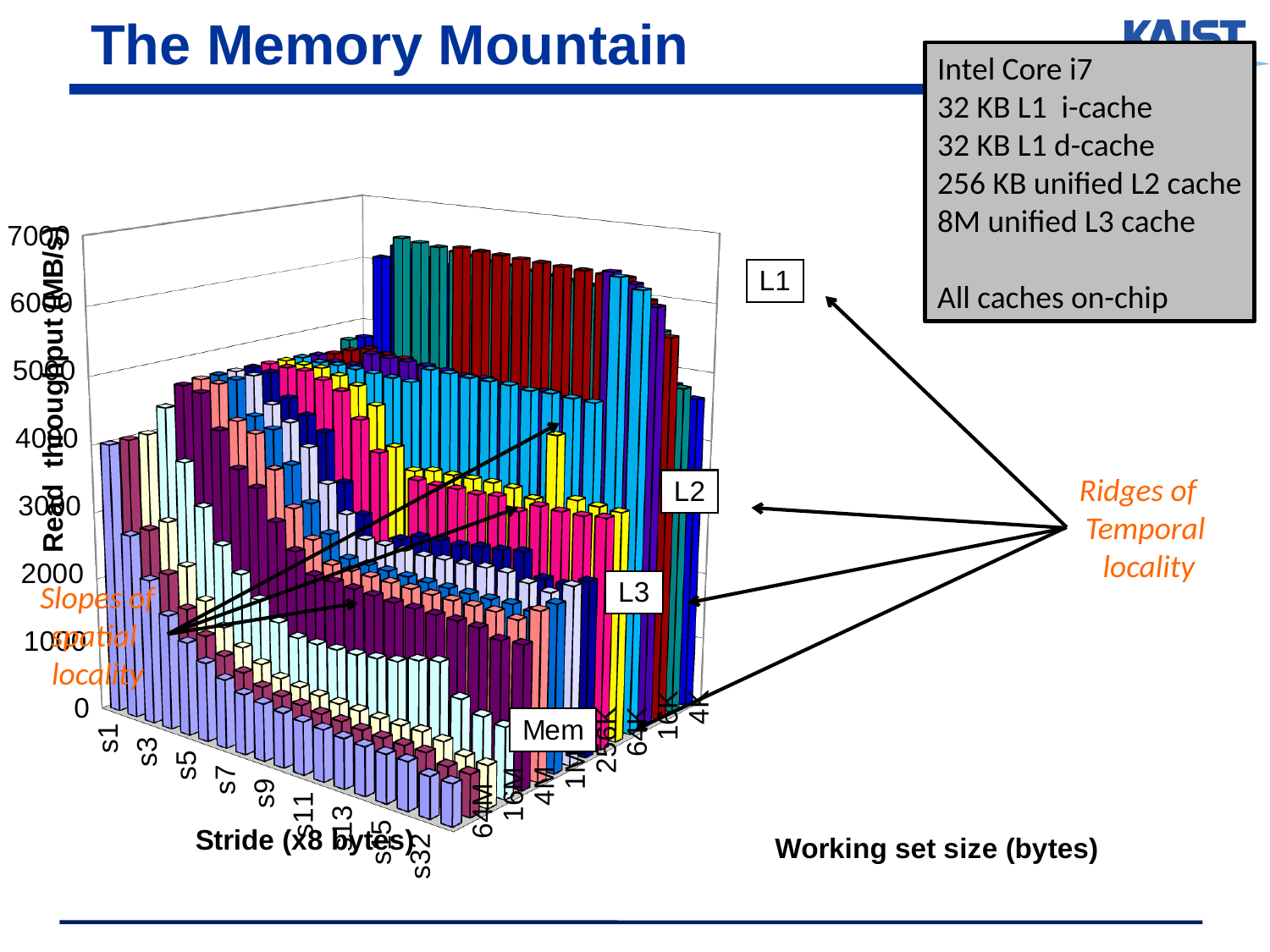
Which labelled ridge of the chart has the highest read throughput? L1 What kind of chart is shown on the slide? 3D bar chart For a fixed stride, does read throughput generally rise or fall as the working set size decreases from 64M toward 4K? rise Is the tallest bar in the chart greater or less than 5000 MB/s? greater Which four labels mark the ridges of the memory mountain, from highest to lowest? L1, L2, L3, Mem Which labelled region of the chart has the lowest read throughput? Mem What is the title of the vertical axis of the chart? Read throughput (MB/s) For a fixed working set size, does read throughput generally rise or fall as the stride increases from s1 to s32? fall Is the read throughput for the L1 ridge larger or smaller than that for the Mem region? larger